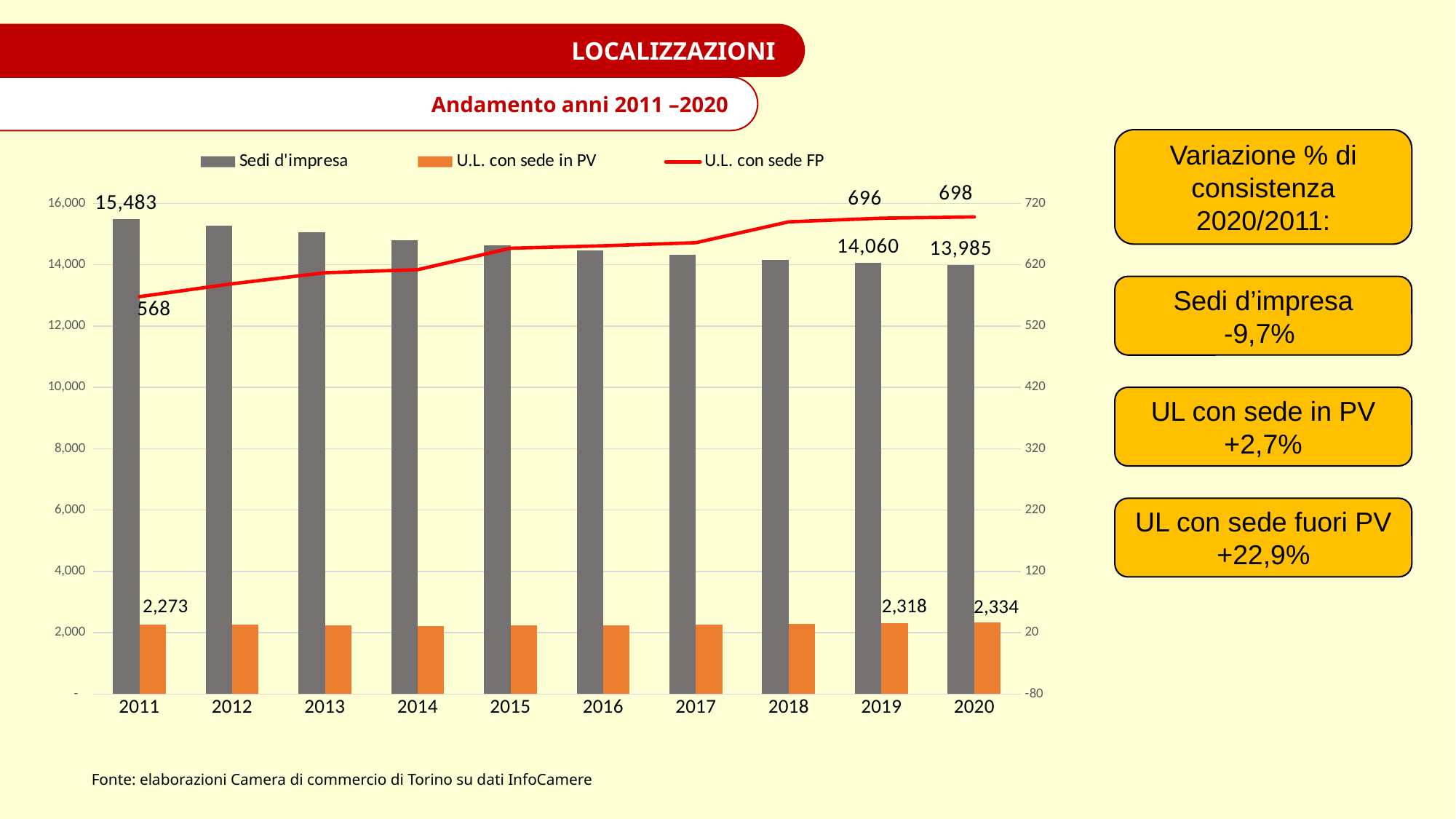
What is the value of U.L. con sede FP in 2011? 568 By how much did U.L. con sede FP increase from 2011 to 2020? 130 Do the values of Sedi d'impresa rise or fall from 2011 to 2020? fall What is the difference between Sedi d'impresa in 2011 and in 2020? 1,498 What is the value of Sedi d'impresa in 2020? 13,985 In which year is Sedi d'impresa highest? 2011 What is the value of U.L. con sede in PV in 2019? 2,318 Which is larger, Sedi d'impresa in 2019 or in 2020? 2019 How many series does the legend list? 3 What is the value of Sedi d'impresa in 2011? 15,483 Is the value of Sedi d'impresa in 2015 greater or less than 14,000? greater How many years are shown on the x axis? 10